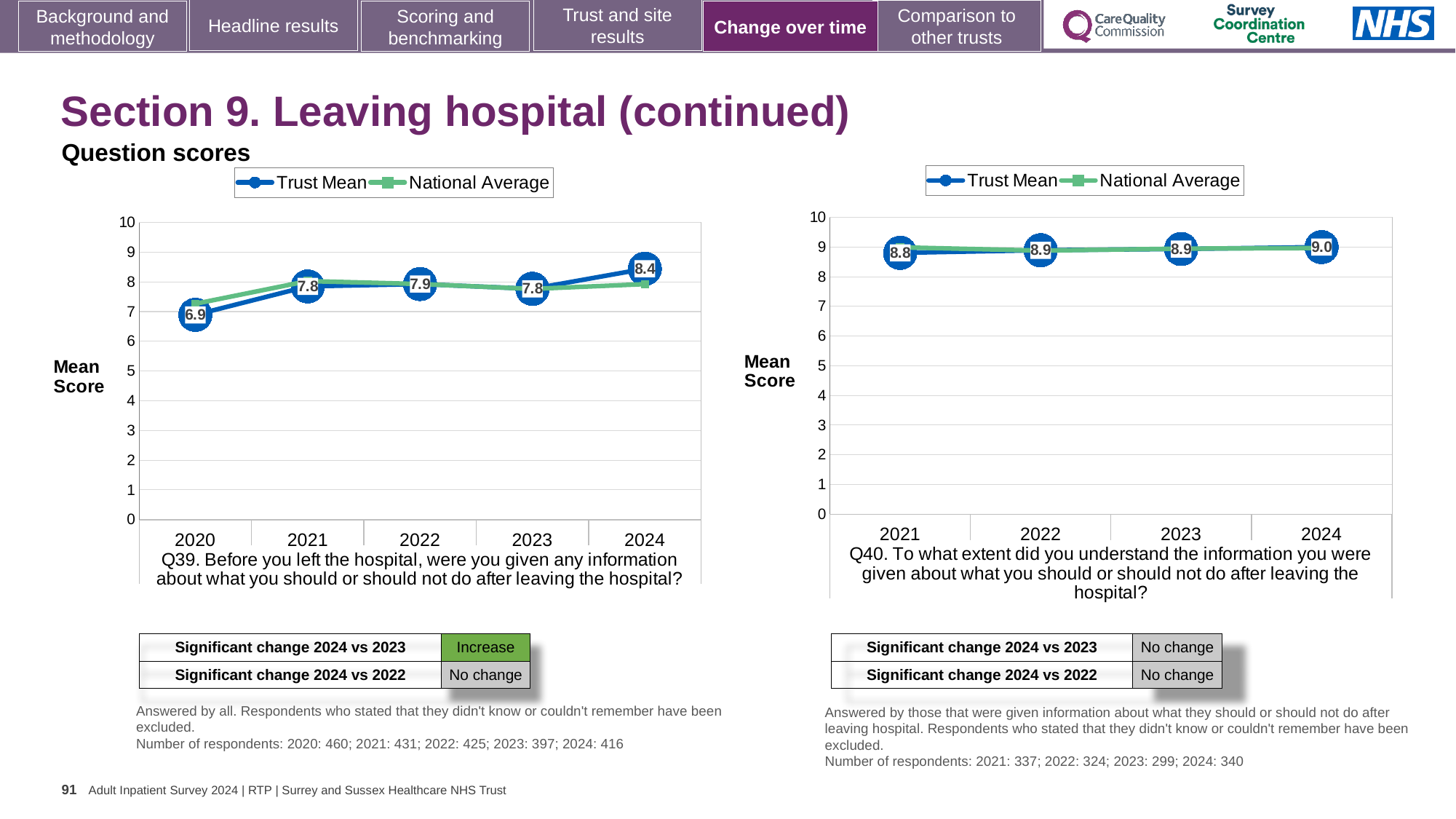
In the Q39 chart on the left, what is the difference between the Trust Mean scores for 2024 and 2023? 0.6 How many years are plotted in the Q40 chart on the right? 4 In the Q39 chart on the left, which year has the lowest Trust Mean score? 2020 In the Q39 chart on the left, is the Trust Mean score higher in 2022 or in 2023? 2022 In the Q39 chart on the left, what is the Trust Mean score for 2020? 6.9 What type of chart is used for Q40 on the right? Line chart In the Q40 chart on the right, what is the Trust Mean score for 2024? 9.0 In the Q39 chart on the left, what is the Trust Mean score for 2024? 8.4 How many series does the legend of the Q39 chart on the left list? 2 In the Q40 chart on the right, what is the difference between the Trust Mean scores for 2024 and 2021? 0.2 In the Q39 chart on the left, which year has the highest Trust Mean score? 2024 In the Q39 chart on the left, is the National Average for 2020 greater or less than 8? less